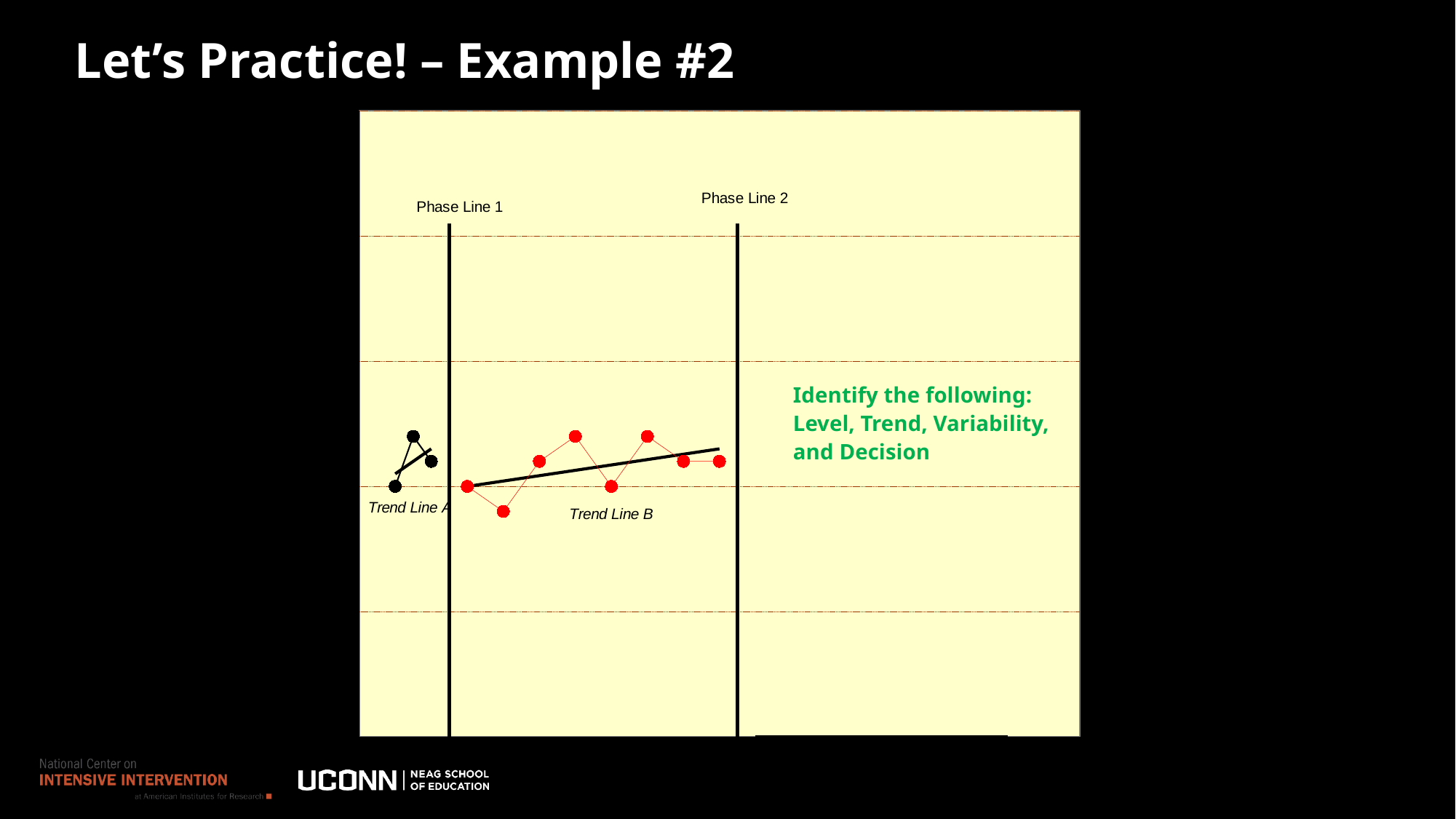
What kind of chart is shown on the slide? line chart How many phase lines are drawn on the chart? 2 How many black data points are plotted to the left of Phase Line 1? 3 What is the label of the trend line drawn through the red data points? Trend Line B Which trend line is drawn through the black data points, Trend Line A or Trend Line B? Trend Line A How many red data points are plotted between Phase Line 1 and Phase Line 2? 8 Does Trend Line B rise or fall from left to right? rise What is the label of the vertical line that separates the black data points from the red data points? Phase Line 1